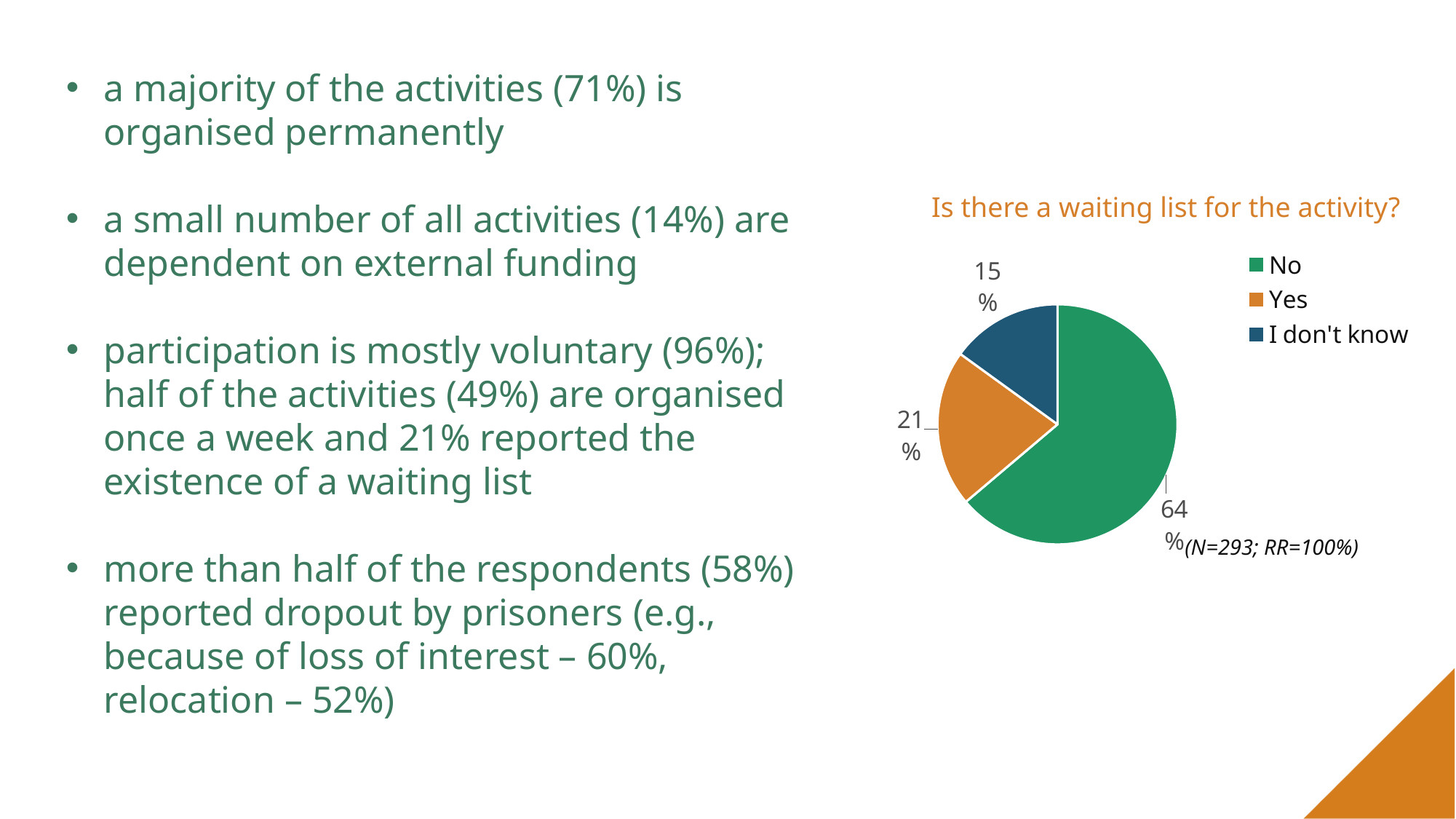
What percentage of the pie chart is labelled "Yes"? 21% Which slice is larger, "Yes" or "I don't know"? Yes Which category has the largest slice of the pie chart? No How many entries does the legend of the pie chart list? 3 How many categories does the pie chart show? 3 What colour is the "Yes" slice in the pie chart? orange What is the title of the pie chart? Is there a waiting list for the activity? Which category has the smallest slice of the pie chart? I don't know What kind of chart is shown on the slide? pie chart What percentage of the pie chart is labelled "No"? 64% What is the difference in percentage points between the "No" and "Yes" slices? 43 What percentage of the pie chart is labelled "I don't know"? 15%